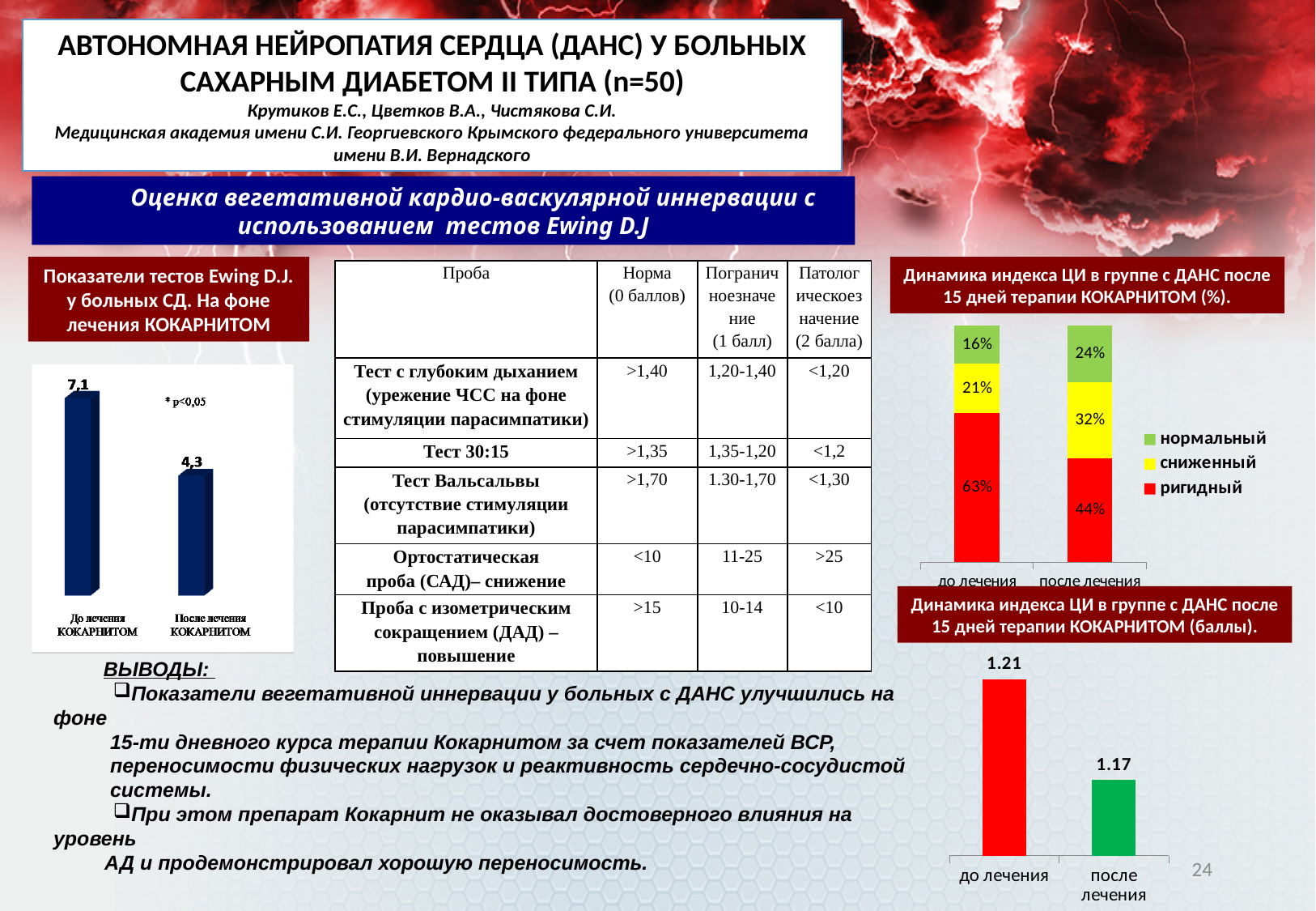
In the stacked bar chart 'Динамика индекса ЦИ в группе с ДАНС после 15 дней терапии КОКАРНИТОМ (%)', what is the share of 'ригидный' before treatment (до лечения)? 63% In the chart titled 'Динамика индекса ЦИ в группе с ДАНС после 15 дней терапии КОКАРНИТОМ (баллы)' (bottom right), what is the value for 'до лечения'? 1.21 In the left chart 'Показатели тестов Ewing D.J.', what is the difference between the 'До лечения' and 'После лечения' values? 2,8 In the stacked bar chart 'Динамика индекса ЦИ ... (%)', how many series does the legend list? 3 In the left chart 'Показатели тестов Ewing D.J.', which category has the higher value, 'До лечения' or 'После лечения'? До лечения In the stacked bar chart 'Динамика индекса ЦИ ... (%)', which colour represents 'ригидный'? Red In the chart titled 'Показатели тестов Ewing D.J. у больных СД. На фоне лечения КОКАРНИТОМ' (left), what is the value for 'После лечения КОКАРНИТОМ'? 4,3 In the chart titled 'Показатели тестов Ewing D.J. у больных СД. На фоне лечения КОКАРНИТОМ' (left), what is the value for 'До лечения КОКАРНИТОМ'? 7,1 In the stacked bar chart 'Динамика индекса ЦИ ... (%)', what is the share of 'сниженный' after treatment (после лечения)? 32% In the stacked bar chart 'Динамика индекса ЦИ ... (%)', by how many percentage points did the 'ригидный' share change from до лечения to после лечения? 19% In the stacked bar chart 'Динамика индекса ЦИ в группе с ДАНС после 15 дней терапии КОКАРНИТОМ (%)', what is the share of 'нормальный' after treatment (после лечения)? 24% In the chart titled 'Динамика индекса ЦИ ... (баллы)' (bottom right), what is the difference between the 'до лечения' and 'после лечения' values? 0.04